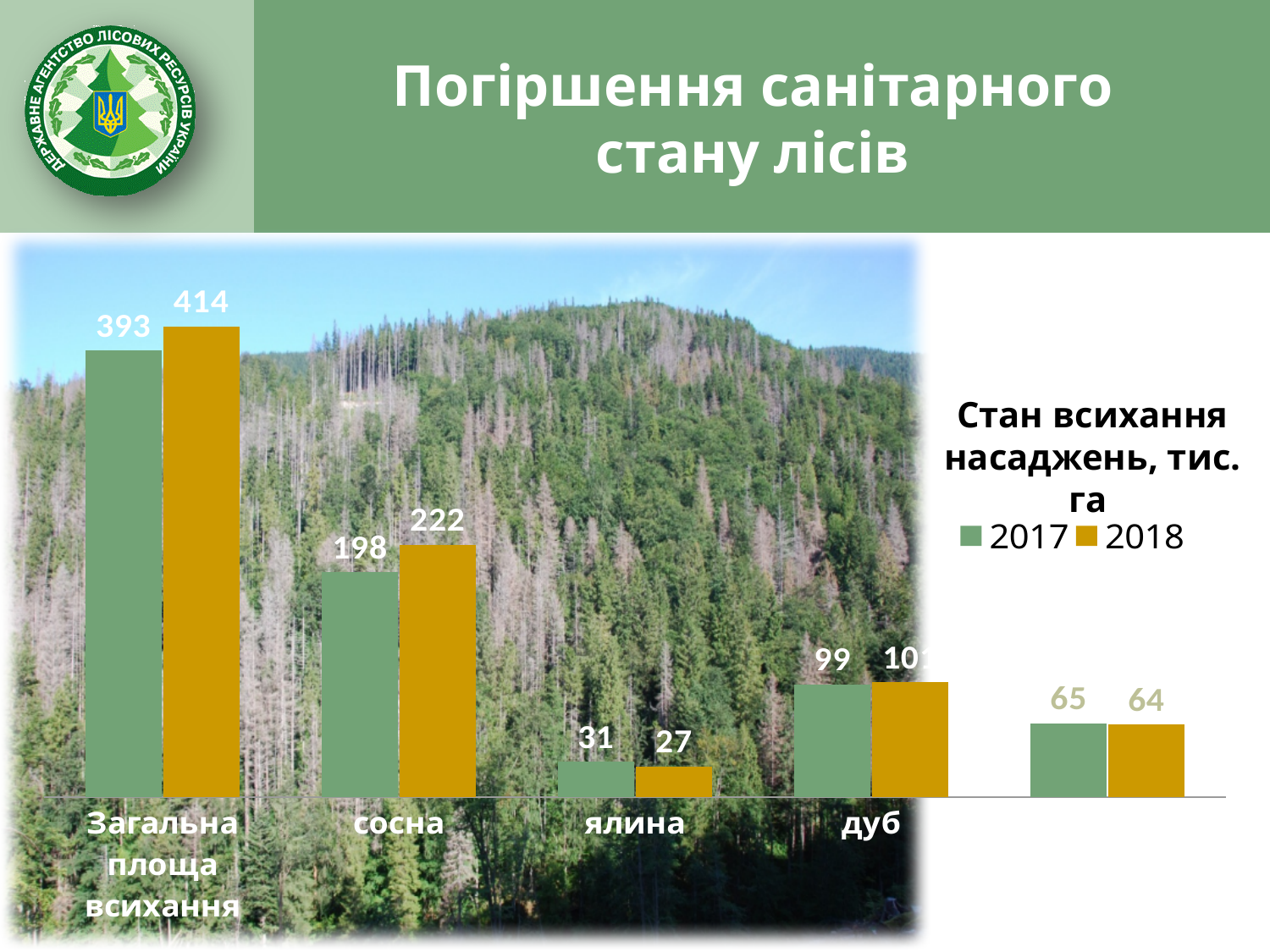
Which category has the lowest 2017 value? ялина What is the 2017 value for дуб? 99 What kind of chart is shown on the slide? Bar chart What is the difference between the 2018 and 2017 values for сосна? 24 For ялина, which year has the larger value, 2017 or 2018? 2017 What is the 2018 value for Загальна площа всихання? 414 Which category has the highest 2018 value? Загальна площа всихання How many series does the legend list? 2 What is the title of the chart? Стан всихання насаджень, тис. га What is the 2017 value for сосна? 198 What is the 2018 value for ялина? 27 What is the difference between the 2018 and 2017 values for Загальна площа всихання? 21